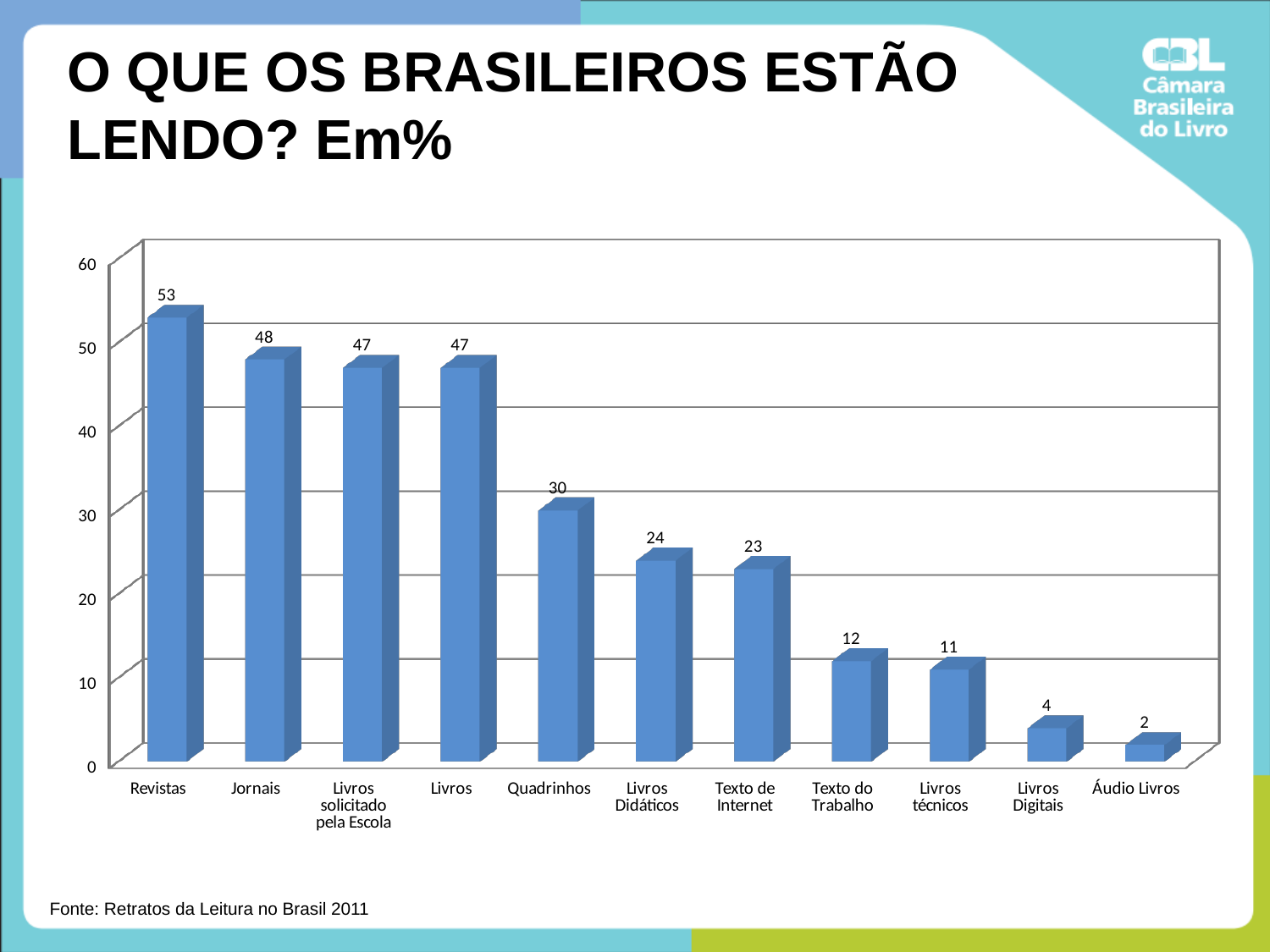
Do the values rise or fall from left to right along the x axis? Fall Which category has the highest value? Revistas What kind of chart is shown on the slide? Bar chart Which is larger, the value for Texto do Trabalho or the value for Livros técnicos? Texto do Trabalho What is the value for Revistas? 53 What is the difference between the values for Quadrinhos and Livros Didáticos? 6 Which category has the lowest value? Áudio Livros How many categories are shown on the x axis? 11 What is the value for Áudio Livros? 2 What is the value for Quadrinhos? 30 What is the value for Texto de Internet? 23 What is the difference between the values for Revistas and Jornais? 5